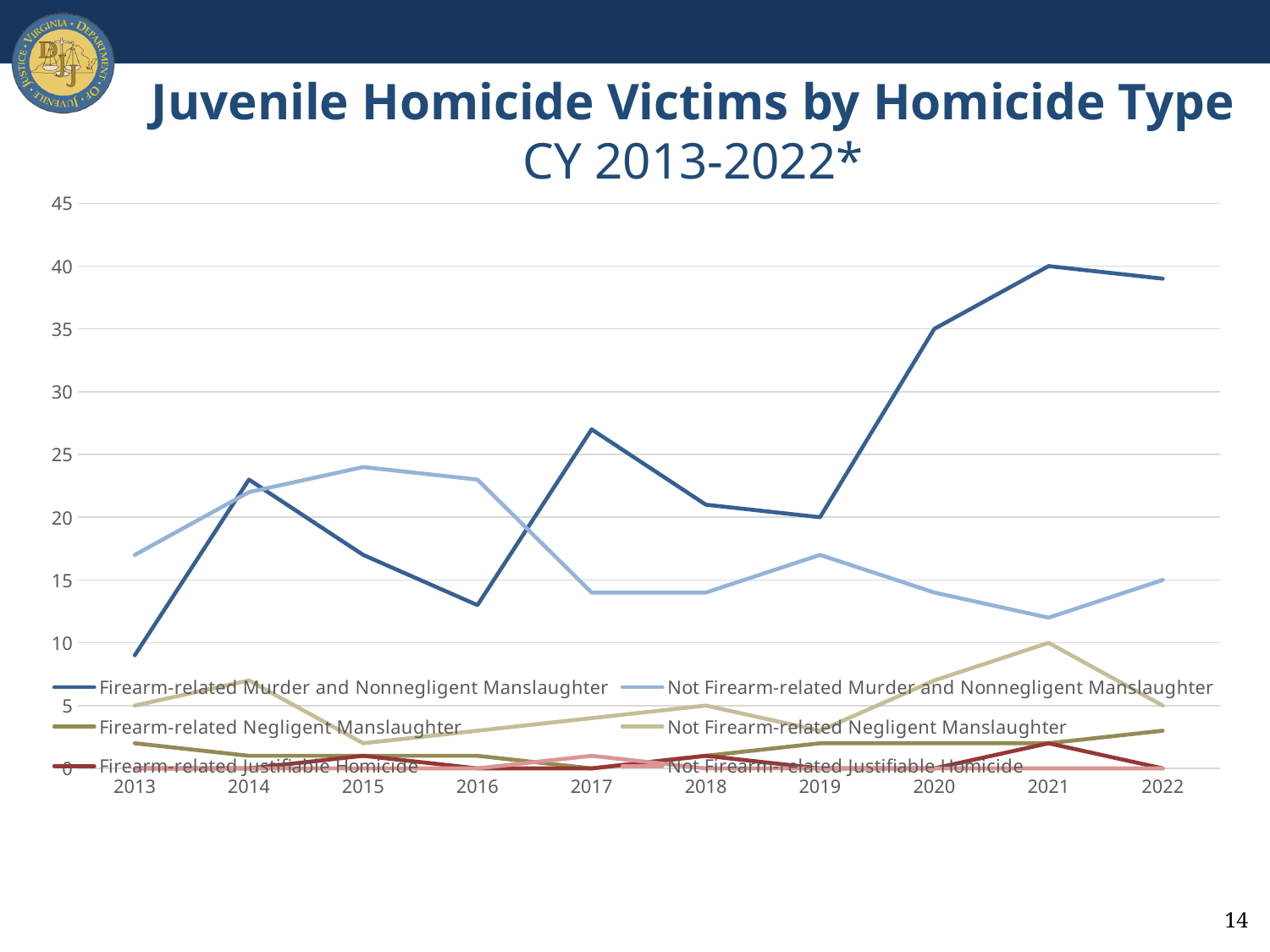
In 2022, which is larger: Firearm-related Murder and Nonnegligent Manslaughter or Not Firearm-related Murder and Nonnegligent Manslaughter? Firearm-related Murder and Nonnegligent Manslaughter Is the value for Firearm-related Murder and Nonnegligent Manslaughter in 2013 greater or less than 10? less What is the value of Firearm-related Murder and Nonnegligent Manslaughter in 2021? 40 Does the Firearm-related Murder and Nonnegligent Manslaughter series rise or fall from 2019 to 2021? rise How many series does the legend list? 6 Is the value for Firearm-related Murder and Nonnegligent Manslaughter in 2017 greater or less than 25? greater What is the value of Firearm-related Murder and Nonnegligent Manslaughter in 2019? 20 How many years are plotted along the x axis? 10 In which year is the Firearm-related Murder and Nonnegligent Manslaughter series at its lowest? 2013 In 2015, which is larger: Firearm-related Murder and Nonnegligent Manslaughter or Not Firearm-related Murder and Nonnegligent Manslaughter? Not Firearm-related Murder and Nonnegligent Manslaughter What kind of chart is shown on the slide? line chart In which year does the Firearm-related Murder and Nonnegligent Manslaughter series reach its highest value? 2021